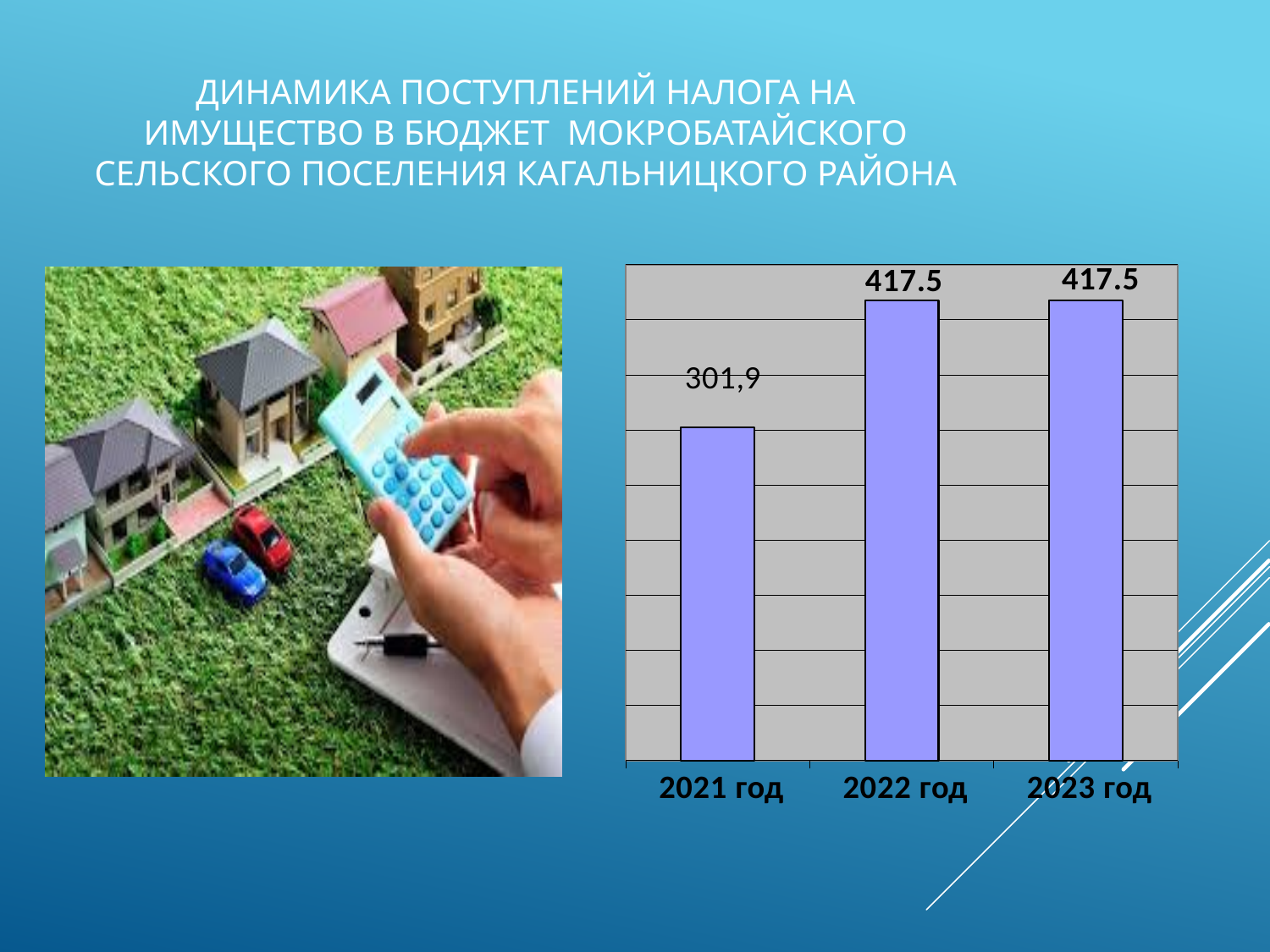
Does the value rise or fall from 2021 год to 2022 год? Rise Are the values for 2022 год and 2023 год equal? Yes Which years are shown on the x axis of the chart? 2021 год, 2022 год, 2023 год What kind of chart is shown on the slide? Bar chart What is the value for 2021 год? 301,9 What is the value for 2022 год? 417.5 What is the difference between the values for 2022 год and 2021 год? 115.6 Which year has the lowest value? 2021 год How many years are shown on the chart? 3 Which is larger, the value for 2021 год or the value for 2022 год? 2022 год What is the value for 2023 год? 417.5